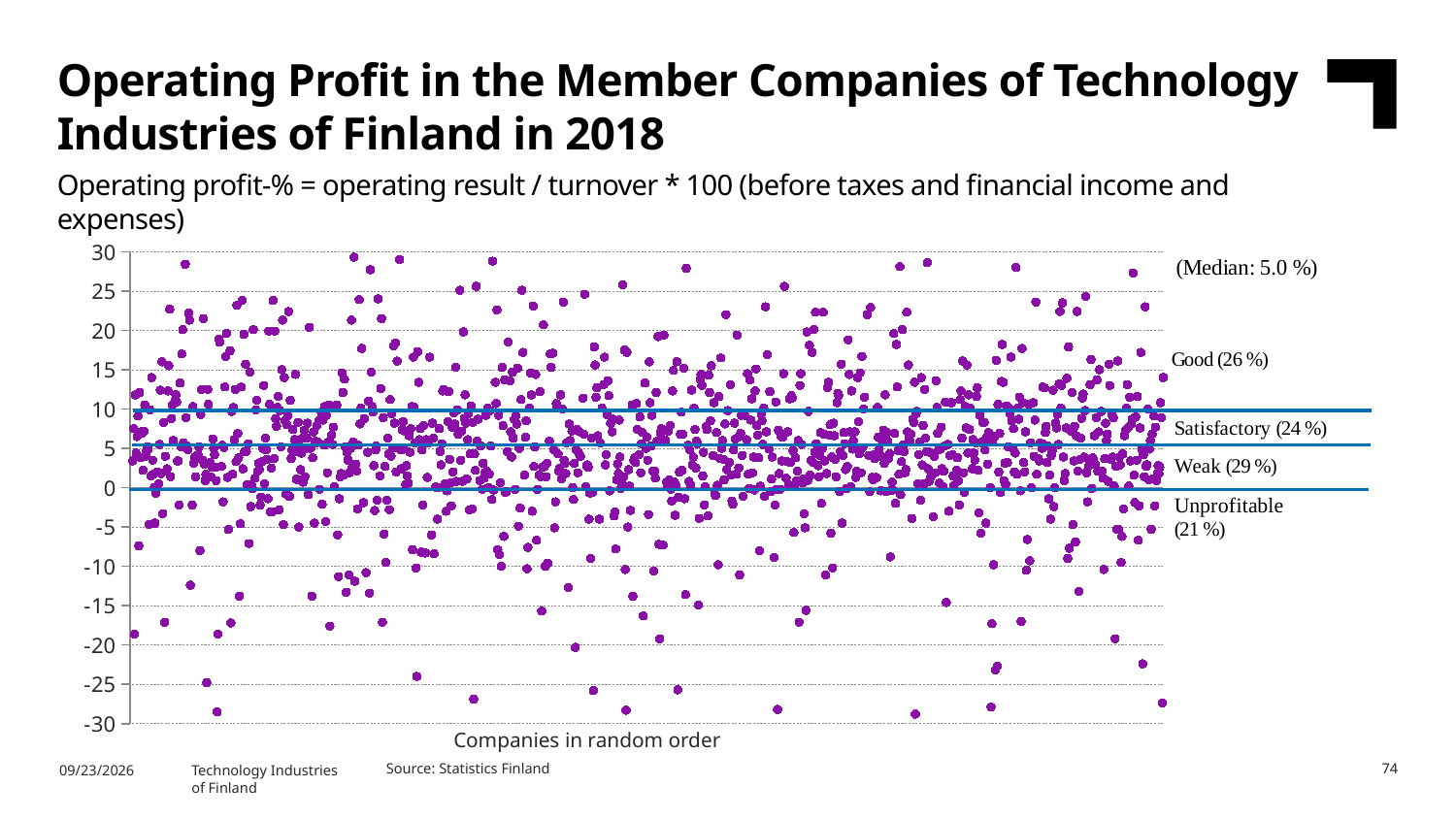
What kind of chart is shown on the slide? Scatter plot How many profitability categories are labelled on the chart? 4 What share of companies is labelled as Good? 26 % What share of companies is labelled as Weak? 29 % Which profitability category has the smallest share of companies? Unprofitable What is the label of the x axis? Companies in random order Which category has a larger share of companies, Good or Satisfactory? Good What share of companies is labelled as Unprofitable? 21 % What is the median operating profit-% shown on the chart? 5.0 % Which profitability category has the largest share of companies? Weak What is the difference in percentage points between the Weak share and the Unprofitable share? 8 What share of companies is labelled as Satisfactory? 24 %